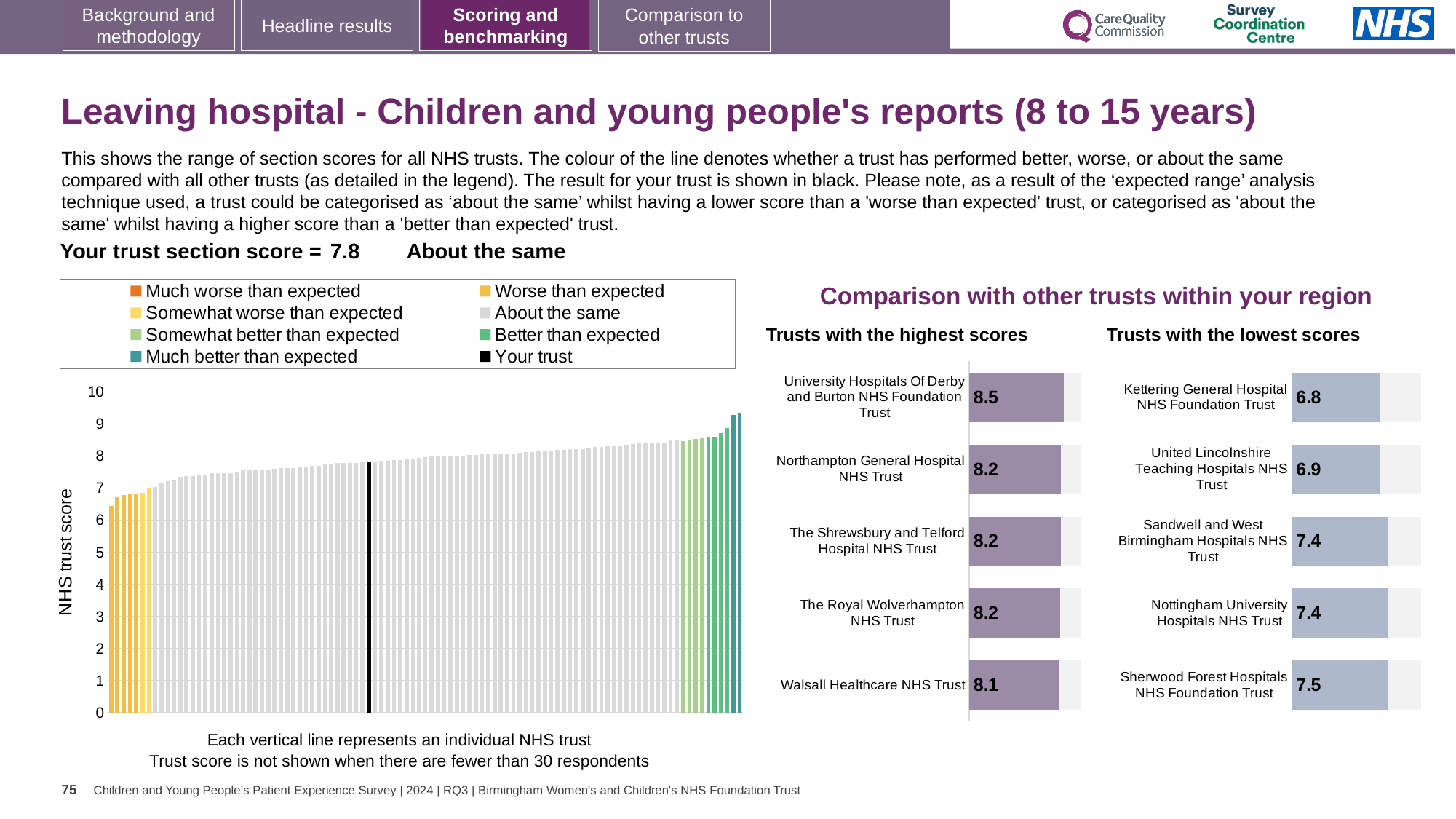
In the 'Trusts with the lowest scores' chart, which has the higher score: Sandwell and West Birmingham Hospitals NHS Trust or United Lincolnshire Teaching Hospitals NHS Trust? Sandwell and West Birmingham Hospitals NHS Trust In the 'Trusts with the highest scores' chart, what is the score for Walsall Healthcare NHS Trust? 8.1 In the 'Trusts with the highest scores' chart, what is the difference between the scores of University Hospitals Of Derby and Burton NHS Foundation Trust and Walsall Healthcare NHS Trust? 0.4 In the 'Trusts with the lowest scores' chart, what is the score for Kettering General Hospital NHS Foundation Trust? 6.8 In the 'Trusts with the lowest scores' chart, what is the difference between the scores of Sherwood Forest Hospitals NHS Foundation Trust and Kettering General Hospital NHS Foundation Trust? 0.7 In the 'Trusts with the highest scores' chart, what is the score for University Hospitals Of Derby and Burton NHS Foundation Trust? 8.5 In the main chart on the left, is the value for the black bar (your trust) greater or less than 8? less In the 'Trusts with the lowest scores' chart, which trust has the lowest score? Kettering General Hospital NHS Foundation Trust How many trusts are shown in the 'Trusts with the highest scores' chart? 5 In the 'Trusts with the lowest scores' chart, what is the score for Sherwood Forest Hospitals NHS Foundation Trust? 7.5 In the 'Trusts with the highest scores' chart, which trust has the highest score? University Hospitals Of Derby and Burton NHS Foundation Trust How many entries does the legend of the main chart on the left list? 8